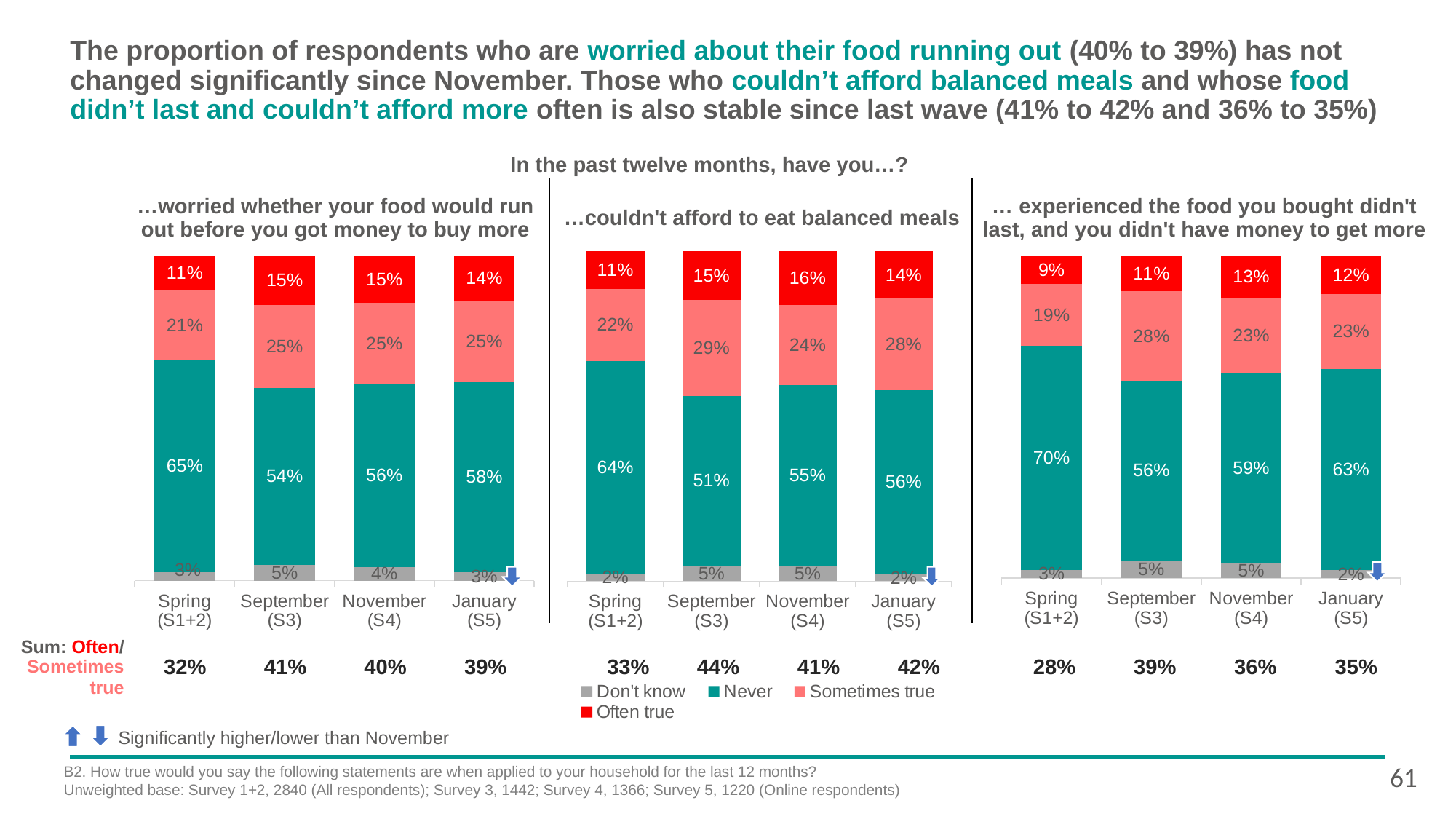
In the chart '…worried whether your food would run out before you got money to buy more', is the 'Sometimes true' value larger for Spring (S1+2) or for January (S5)? January (S5) In the chart '…couldn't afford to eat balanced meals', what is the combined 'Often true' and 'Sometimes true' total for January (S5)? 42% In the chart '… experienced the food you bought didn't last, and you didn't have money to get more', which survey wave has the lowest 'Often true' value? Spring (S1+2) Which colour represents 'Often true' in the legend? Red What kind of chart is used on this slide? Stacked bar chart How many series does the legend list? 4 In the chart '…couldn't afford to eat balanced meals', what is the 'Often true' value for November (S4)? 16% How many survey waves are shown in each chart? 4 In the chart '… experienced the food you bought didn't last, and you didn't have money to get more', what is the 'Sometimes true' value for September (S3)? 28% In the chart '…worried whether your food would run out before you got money to buy more', which survey wave has the highest 'Never' value? Spring (S1+2) In the chart '…couldn't afford to eat balanced meals', what is the difference between the 'Never' values for Spring (S1+2) and September (S3)? 13 percentage points In the chart '…worried whether your food would run out before you got money to buy more', what is the 'Never' value for Spring (S1+2)? 65%